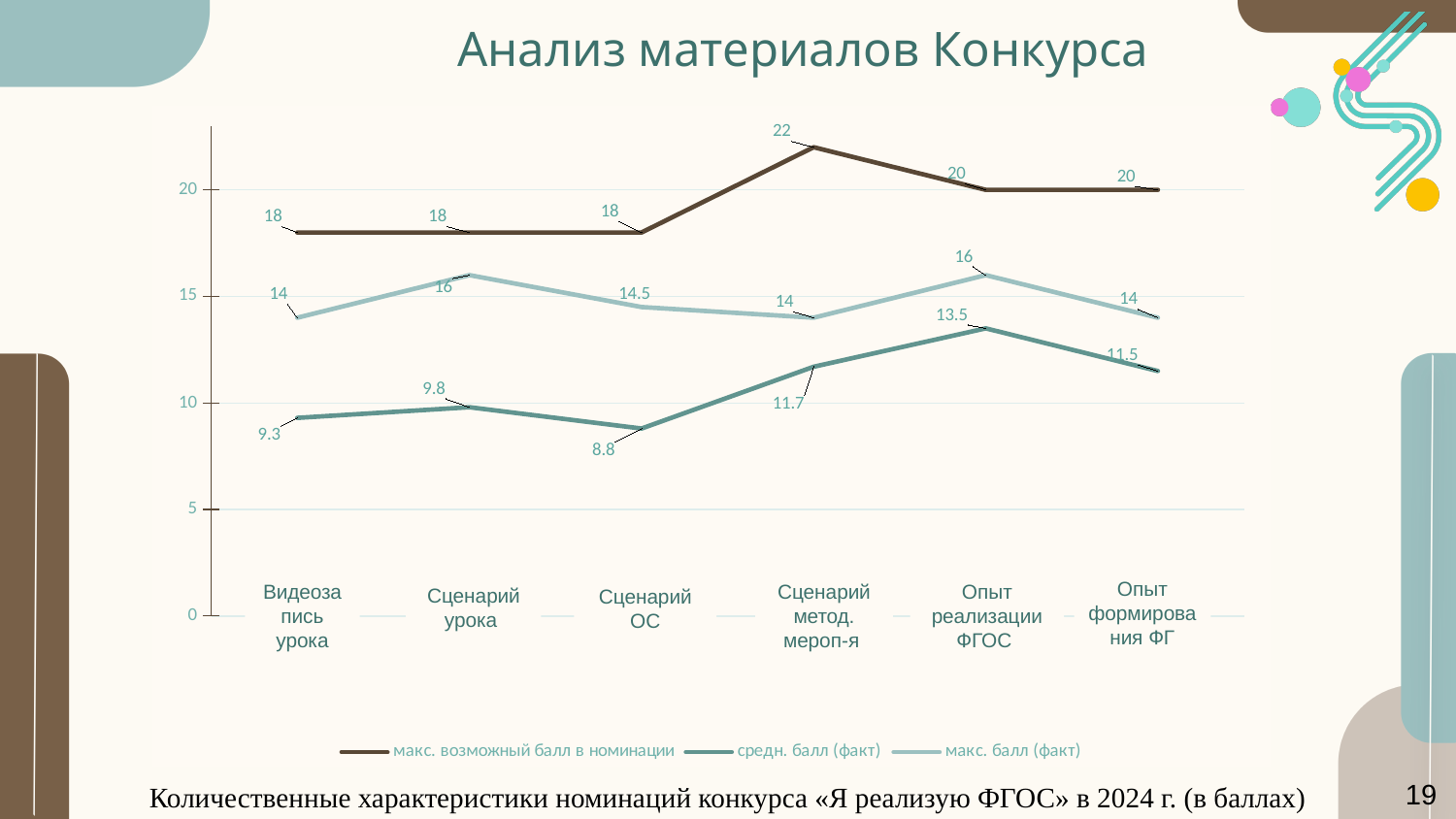
What is the difference between 'макс. возможный балл в номинации' and 'средн. балл (факт)' for 'Опыт реализации ФГОС'? 6.5 What is the value of 'средн. балл (факт)' for 'Сценарий ОС'? 8.8 What is the value of 'макс. возможный балл в номинации' for 'Сценарий метод. мероп-я'? 22 What type of chart is shown on the slide? line chart What is the value of 'макс. балл (факт)' for 'Сценарий урока'? 16 How many categories are shown on the x axis? 6 Does 'средн. балл (факт)' rise or fall from 'Опыт реализации ФГОС' to 'Опыт формирования ФГ'? fall Which category has the lowest value for 'средн. балл (факт)'? Сценарий ОС Which is larger for 'Сценарий метод. мероп-я': 'макс. балл (факт)' or 'средн. балл (факт)'? макс. балл (факт) Which category has the highest value for 'средн. балл (факт)'? Опыт реализации ФГОС How many series does the legend list? 3 Is the value of 'средн. балл (факт)' for 'Видеозапись урока' greater or less than 10? less